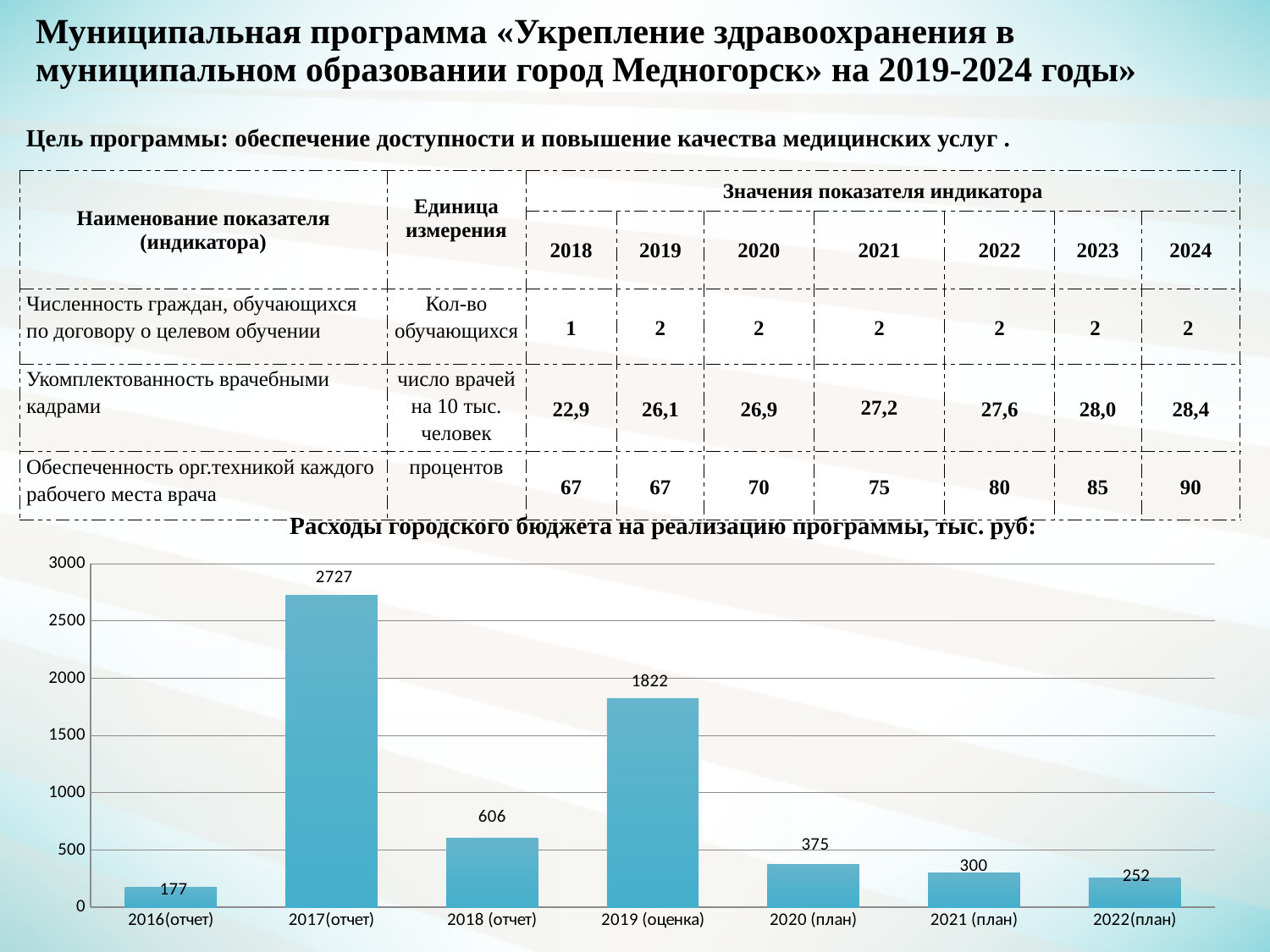
Which category has the lowest value in the chart? 2016(отчет) What is the value for 2021 (план) in the chart? 300 How many categories are shown on the x axis of the chart? 7 What is the value for 2019 (оценка) in the chart? 1822 What is the value for 2016(отчет) in the chart? 177 Is the value for 2022(план) greater or less than 500? less Which is larger, the value for 2018 (отчет) or the value for 2020 (план)? 2018 (отчет) What is the difference between the values for 2017(отчет) and 2019 (оценка)? 905 What kind of chart is shown on the slide? bar chart What is the value for 2017(отчет) in the chart? 2727 Which category has the highest value in the chart? 2017(отчет) What is the title of the chart? Расходы городского бюджета на реализацию программы, тыс. руб: